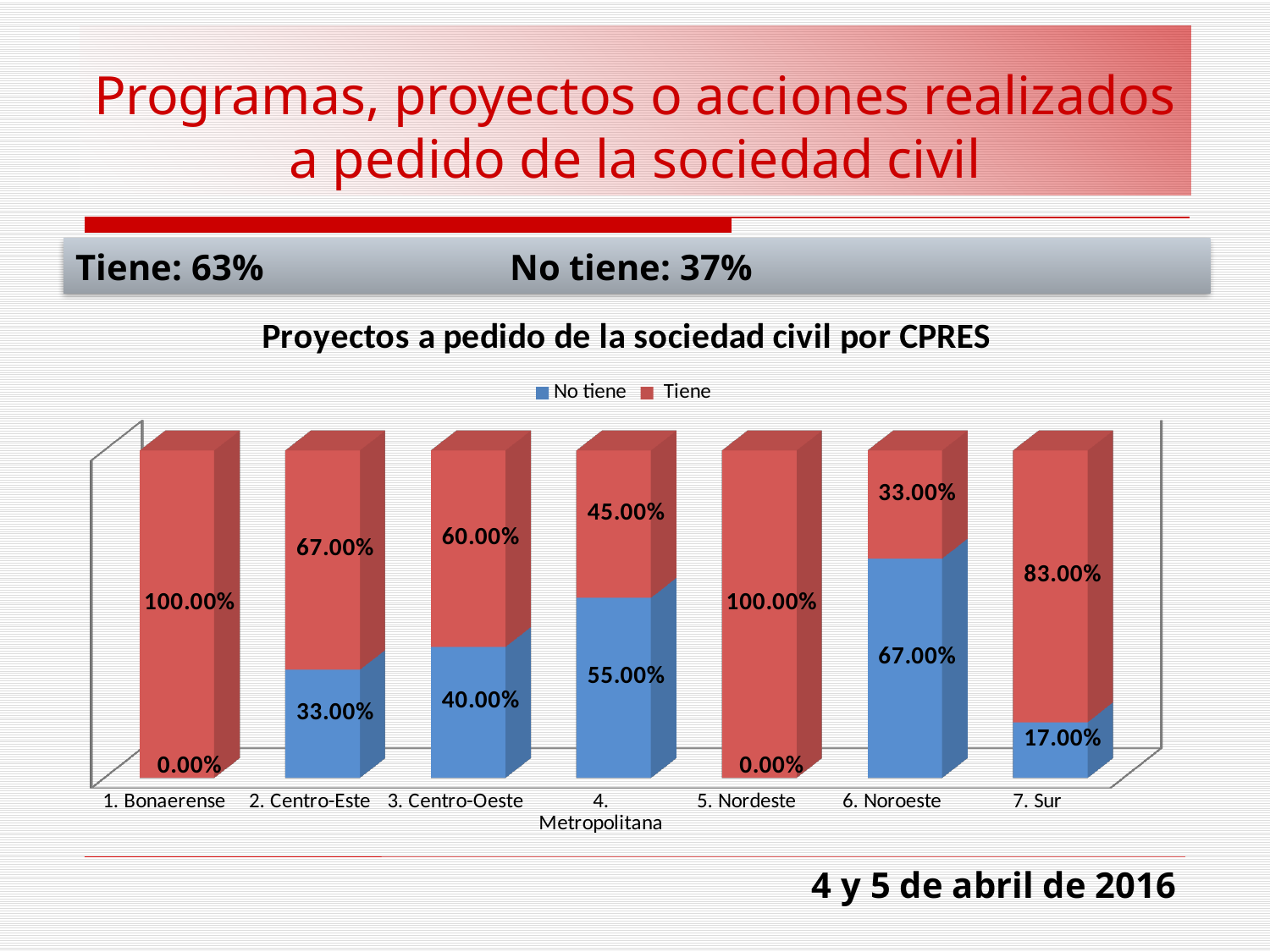
What kind of chart is shown on the slide? Stacked bar chart How many categories are shown on the x axis? 7 How many series does the legend list? 2 Which category has the lowest 'Tiene' value? 6. Noroeste Which category has the highest 'No tiene' value? 6. Noroeste What is the 'Tiene' value for 2. Centro-Este? 67.00% What is the 'No tiene' value for 4. Metropolitana? 55.00% What is the difference between the 'Tiene' and 'No tiene' values for 7. Sur? 66.00% Which is larger for 4. Metropolitana, the 'Tiene' value or the 'No tiene' value? No tiene What is the 'No tiene' value for 7. Sur? 17.00% What is the title of the chart? Proyectos a pedido de la sociedad civil por CPRES What is the 'Tiene' value for 3. Centro-Oeste? 60.00%